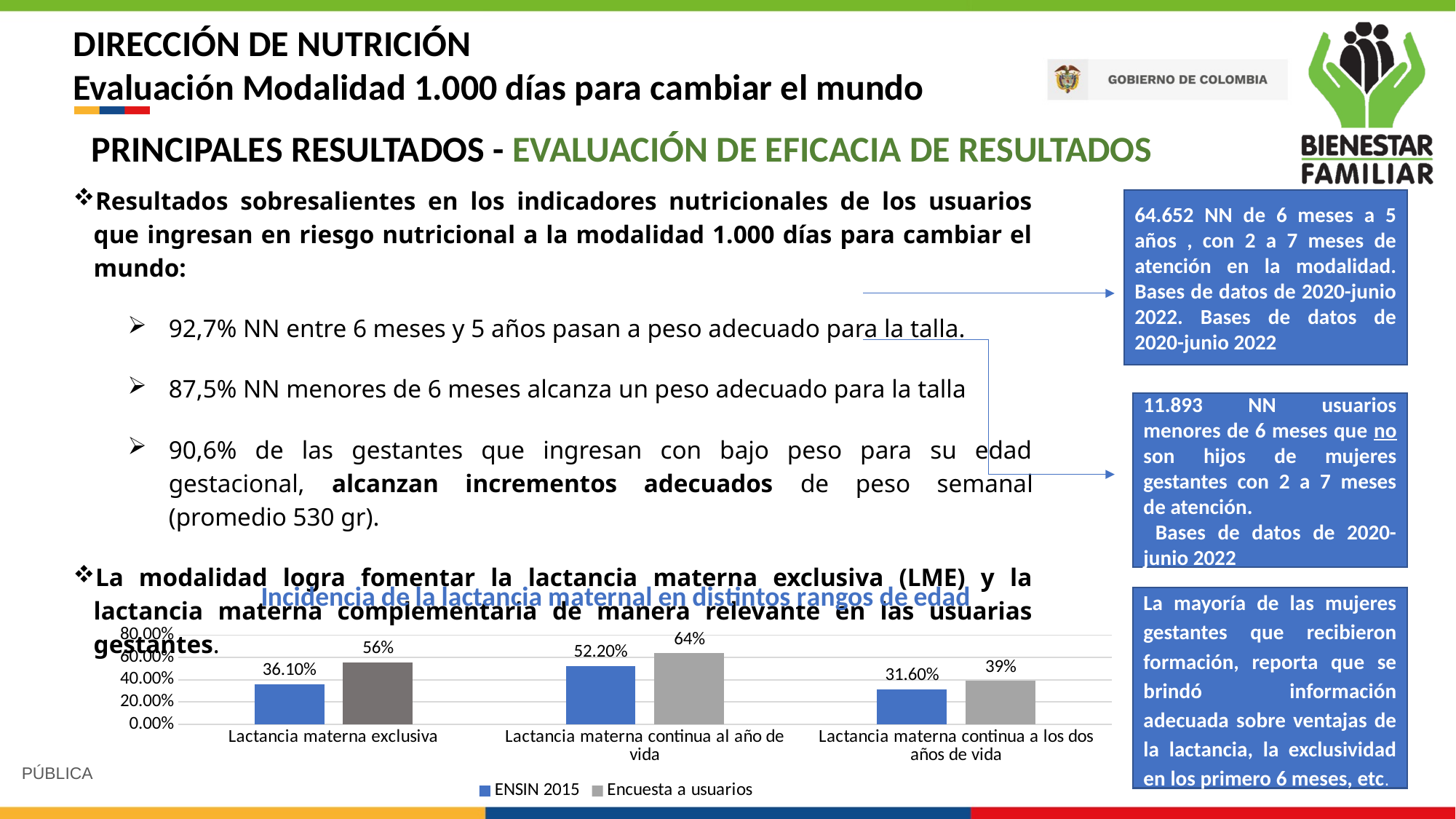
Which category has the lowest ENSIN 2015 value? Lactancia materna continua a los dos años de vida What is the ENSIN 2015 value for Lactancia materna exclusiva? 36.10% What is the ENSIN 2015 value for Lactancia materna continua al año de vida? 52.20% What is the Encuesta a usuarios value for Lactancia materna continua a los dos años de vida? 39% What type of chart is shown on the slide? Bar chart How many categories are shown on the x axis of the chart? 3 What is the title of the chart? Incidencia de la lactancia maternal en distintos rangos de edad What is the difference between the Encuesta a usuarios and ENSIN 2015 values for Lactancia materna exclusiva? 19.9 percentage points What is the Encuesta a usuarios value for Lactancia materna continua al año de vida? 64% For Lactancia materna continua a los dos años de vida, which series has the larger value, ENSIN 2015 or Encuesta a usuarios? Encuesta a usuarios How many series does the chart legend list? 2 Which category has the highest Encuesta a usuarios value? Lactancia materna continua al año de vida